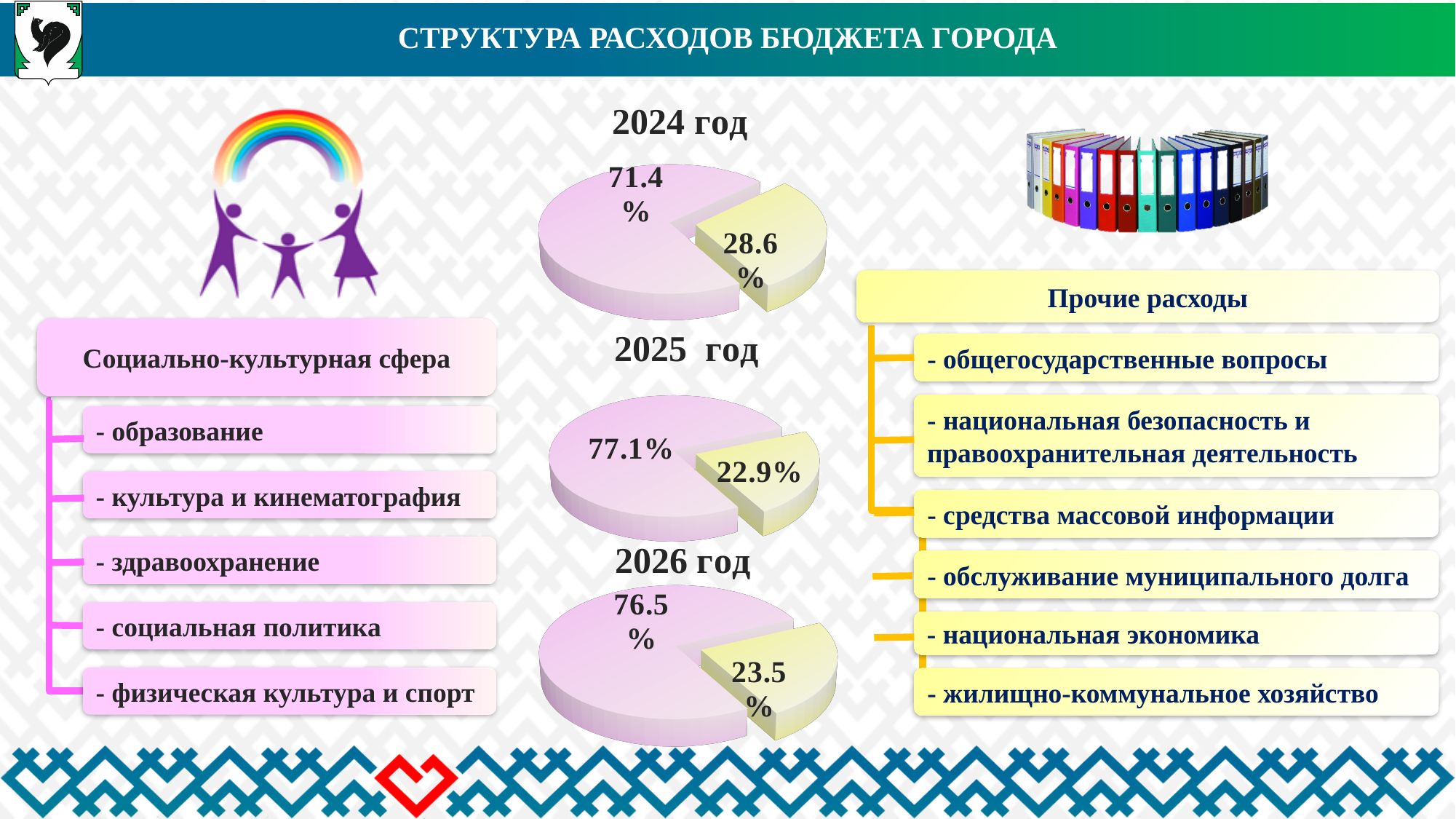
How many pie charts are shown on the slide? 3 Across the three pie charts, in which year is the pink slice the largest? 2025 год In the 2026 год pie chart, what is the value of the yellow slice? 23.5% In the 2024 год pie chart, what is the value of the smaller (yellow) slice? 28.6% In the 2025 год pie chart, what is the value of the yellow slice? 22.9% How many slices does the 2025 год pie chart have? 2 In the 2025 год pie chart, what is the value of the pink slice? 77.1% In the 2026 год pie chart, what is the value of the pink slice? 76.5% In the 2024 год pie chart, what is the value of the larger (pink) slice? 71.4% What kind of chart is used for 2024 год, 2025 год and 2026 год? Pie chart In the 2024 год pie chart, what is the difference between the pink slice and the yellow slice? 42.8% Which pie chart has the larger yellow slice, 2025 год or 2026 год? 2026 год